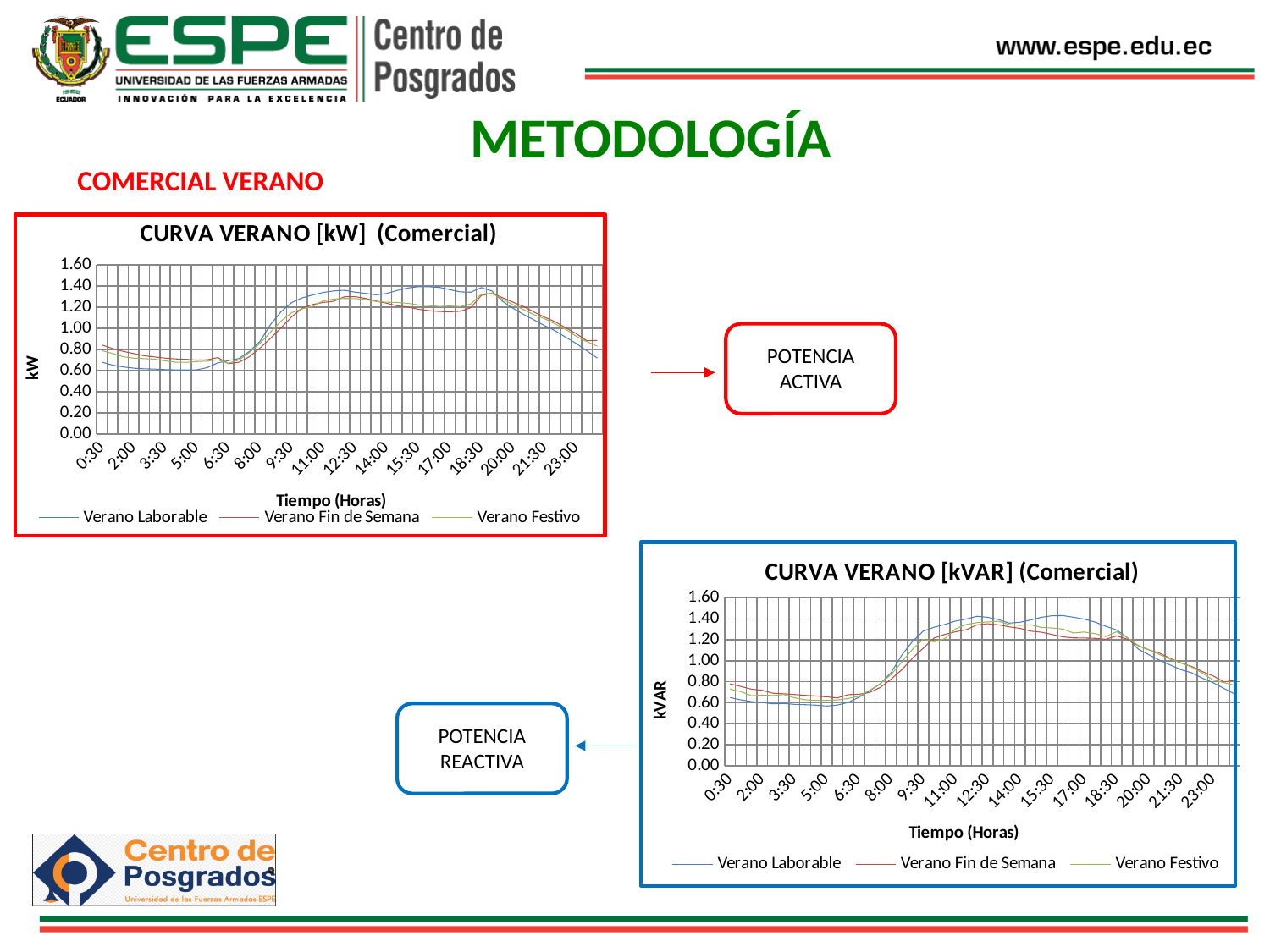
In the 'CURVA VERANO [kVAR] (Comercial)' chart, is the value for Verano Laborable at 5:00 greater or less than 0.80? less What is the highest value shown on the y axis of the 'CURVA VERANO [kVAR] (Comercial)' chart? 1.60 In the 'CURVA VERANO [kW] (Comercial)' chart, do the values rise or fall between 6:30 and 11:00? rise What are the three series named in the legend of the 'CURVA VERANO [kW] (Comercial)' chart? Verano Laborable, Verano Fin de Semana, Verano Festivo In the 'CURVA VERANO [kVAR] (Comercial)' chart, is the value for Verano Laborable at 15:30 greater or less than 1.20? greater What kind of chart is the 'CURVA VERANO [kW] (Comercial)' chart? line chart What is the x-axis title of the 'CURVA VERANO [kVAR] (Comercial)' chart? Tiempo (Horas) How many series does the legend of the 'CURVA VERANO [kVAR] (Comercial)' chart list? 3 In the 'CURVA VERANO [kW] (Comercial)' chart, is the value for Verano Laborable at 15:30 greater or less than 1.20? greater How many time labels are shown on the x axis of the 'CURVA VERANO [kW] (Comercial)' chart? 16 In the 'CURVA VERANO [kVAR] (Comercial)' chart, do the values rise or fall between 18:30 and 23:00? fall